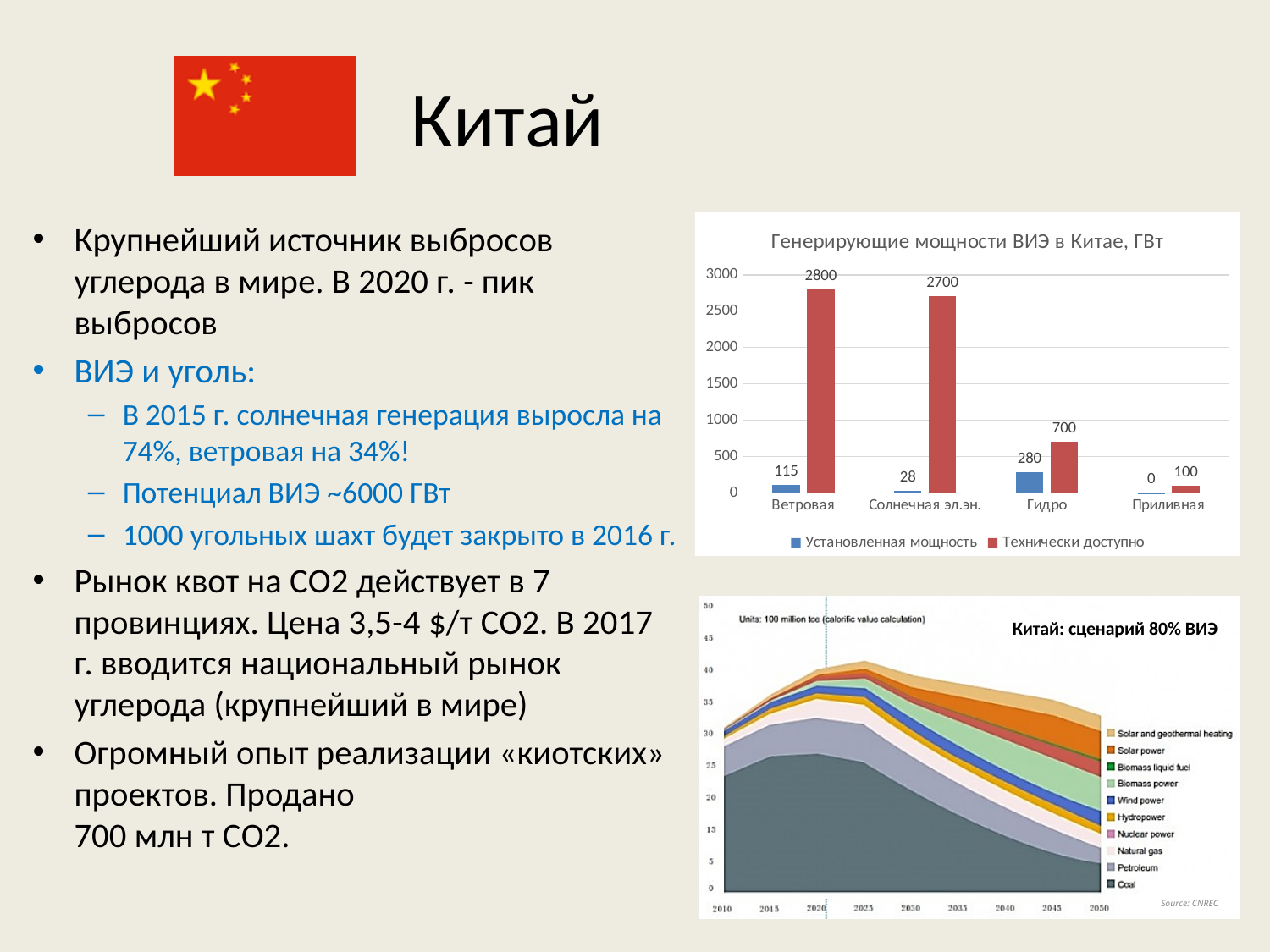
In the chart 'Китай: сценарий 80% ВИЭ', does the Coal area rise or fall from 2020 to 2050? Fall In the chart 'Генерирующие мощности ВИЭ в Китае, ГВт', which category has the highest 'Технически доступно' value? Ветровая In the chart 'Генерирующие мощности ВИЭ в Китае, ГВт', what is the value of 'Установленная мощность' for Гидро? 280 In the chart 'Генерирующие мощности ВИЭ в Китае, ГВт', what is the value of 'Технически доступно' for Ветровая? 2800 In the chart 'Генерирующие мощности ВИЭ в Китае, ГВт', what is the difference between 'Технически доступно' and 'Установленная мощность' for Гидро? 420 What kind of chart is the top chart on the right side of the slide? Bar chart In the chart 'Генерирующие мощности ВИЭ в Китае, ГВт', which is larger: 'Технически доступно' for Ветровая or for Солнечная эл.эн.? Ветровая In the chart 'Генерирующие мощности ВИЭ в Китае, ГВт', how many series does the legend list? 2 In the chart 'Китай: сценарий 80% ВИЭ', how many entries does the legend list? 10 In the chart 'Генерирующие мощности ВИЭ в Китае, ГВт', which category has the lowest 'Установленная мощность' value? Приливная In the chart 'Генерирующие мощности ВИЭ в Китае, ГВт', how many categories are shown on the x axis? 4 In the chart 'Генерирующие мощности ВИЭ в Китае, ГВт', what is the value of 'Установленная мощность' for Солнечная эл.эн.? 28